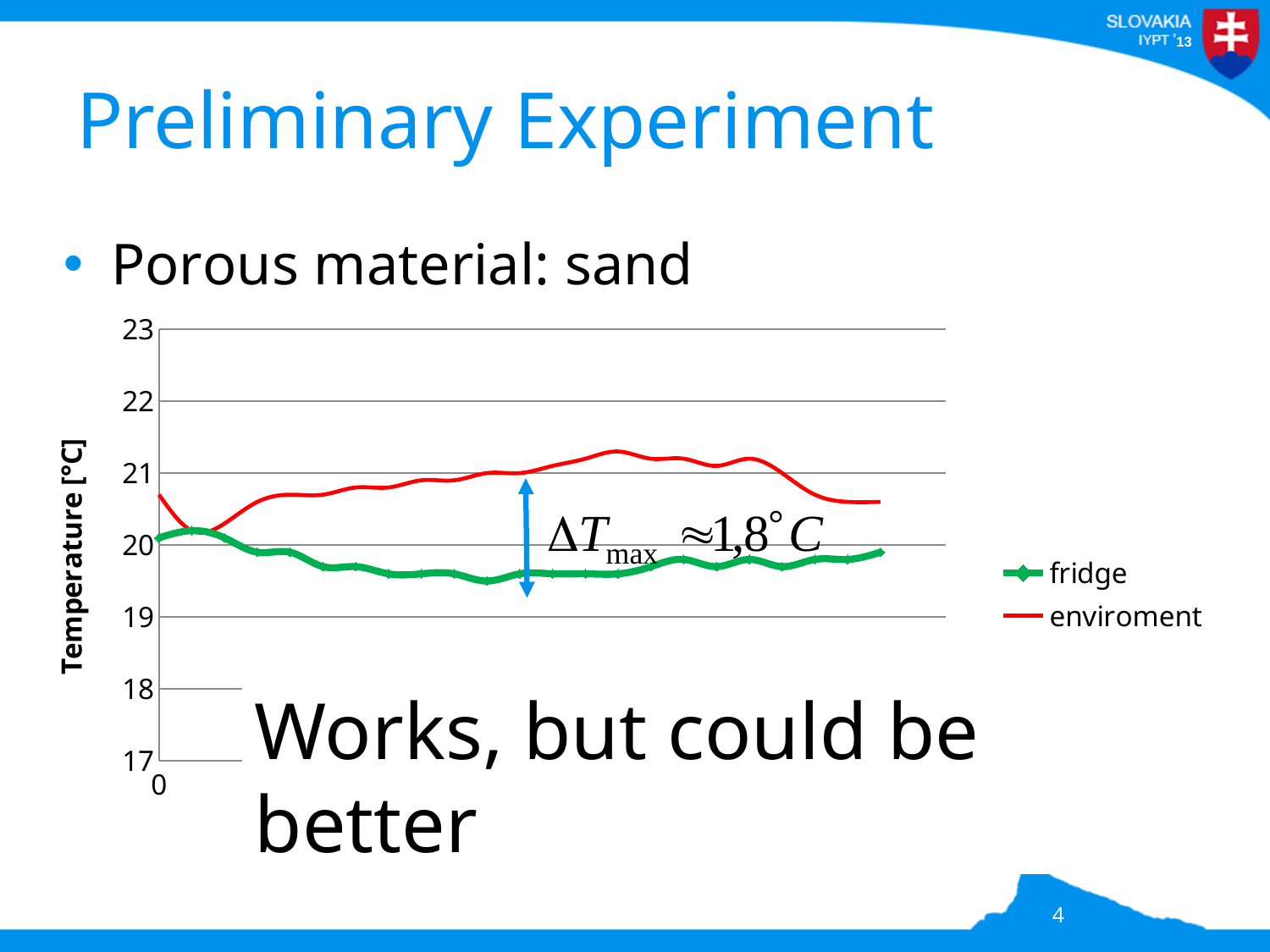
What are the two series named in the chart legend? fridge and enviroment Is the highest value of the enviroment series greater or less than 22? less Does the enviroment series rise or fall from the start of the chart to its middle? rise What is the label of the chart's vertical axis? Temperature [°C] Is the lowest value of the fridge series greater or less than 20? less Does the fridge series rise or fall over the first part of the chart? fall What is the highest tick value shown on the vertical axis? 23 What kind of chart is shown on the slide? line chart Is the highest value of the enviroment series greater or less than 21? greater How many series does the chart legend list? 2 Which series has the higher temperature values across the chart, fridge or enviroment? enviroment